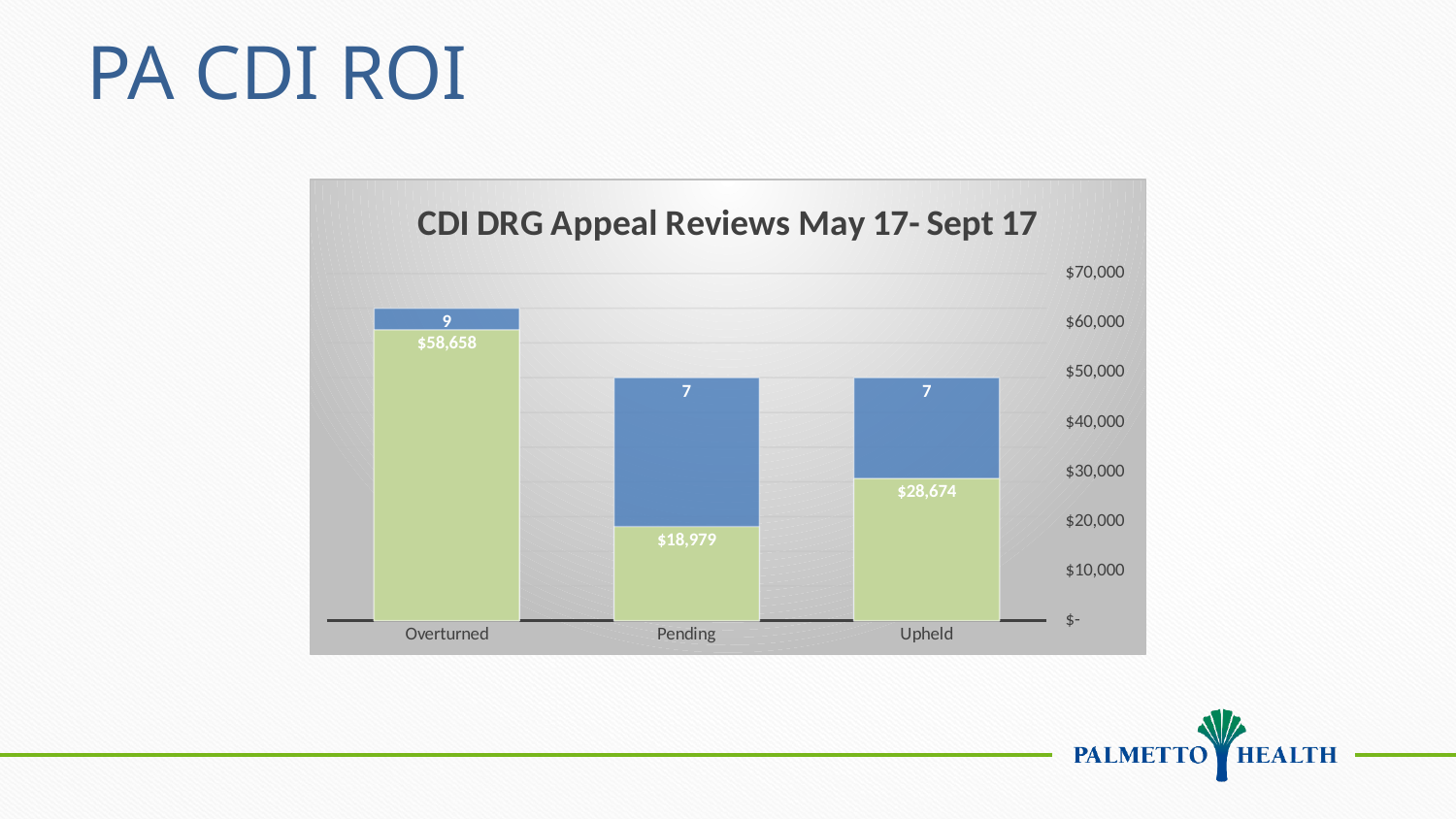
What is the title of the chart? CDI DRG Appeal Reviews May 17- Sept 17 What dollar value is labeled on the green segment of the Overturned bar? $58,658 Which has a larger labeled dollar value, Pending or Upheld? Upheld Which category has the lowest dollar value labeled on its green segment? Pending What is the difference between the dollar values labeled for Overturned and Upheld? $29,984 What dollar value is labeled on the green segment of the Pending bar? $18,979 What kind of chart is shown on the slide? Stacked bar chart What number is labeled on the blue segment of the Pending bar? 7 What number is labeled on the blue segment of the Overturned bar? 9 Which category has the highest dollar value labeled on its green segment? Overturned What dollar value is labeled on the green segment of the Upheld bar? $28,674 How many categories are shown on the x axis? 3